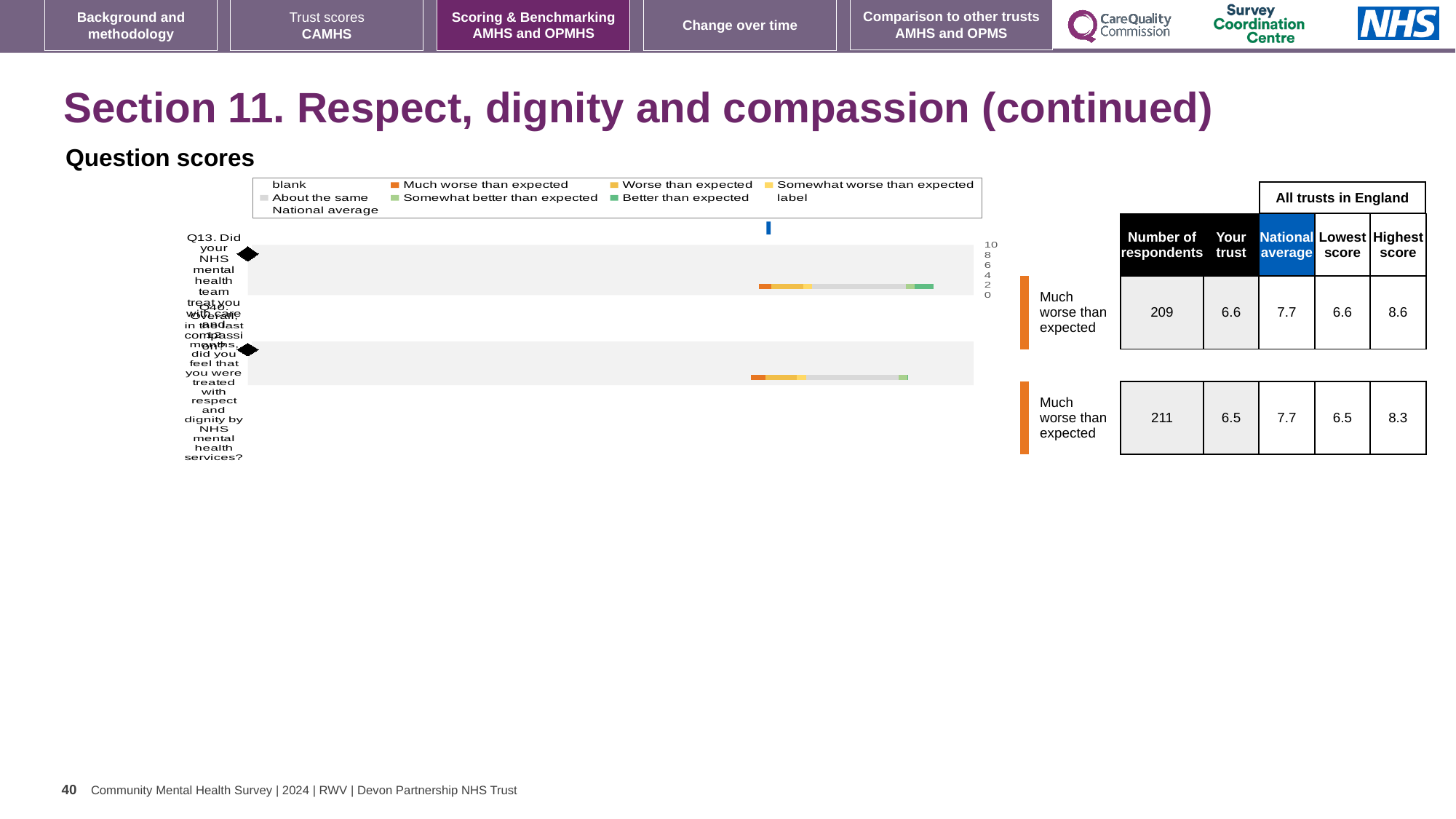
How many respondents are shown for Q10? 211 What kind of chart is used to show the question scores on this slide? bar chart What is the highest score across all trusts in England for Q10? 8.3 What is the difference between the highest score and the lowest score for Q13? 2.0 How many questions are plotted in the question scores chart? 2 What is the national average score shown for Q13? 7.7 How many entries does the legend of the question scores chart list? 9 What is the 'Your trust' score for Q10 (Overall, in the last 12 months, did you feel that you were treated with respect and dignity)? 6.5 Which question has the higher 'Your trust' score, Q13 or Q10? Q13 What colour does the legend use for 'Much worse than expected'? orange Which benchmark category is shown next to both Q13 and Q10 in the question scores chart? Much worse than expected What is the 'Your trust' score for Q13 (Did your NHS mental health team treat you with care and compassion)? 6.6